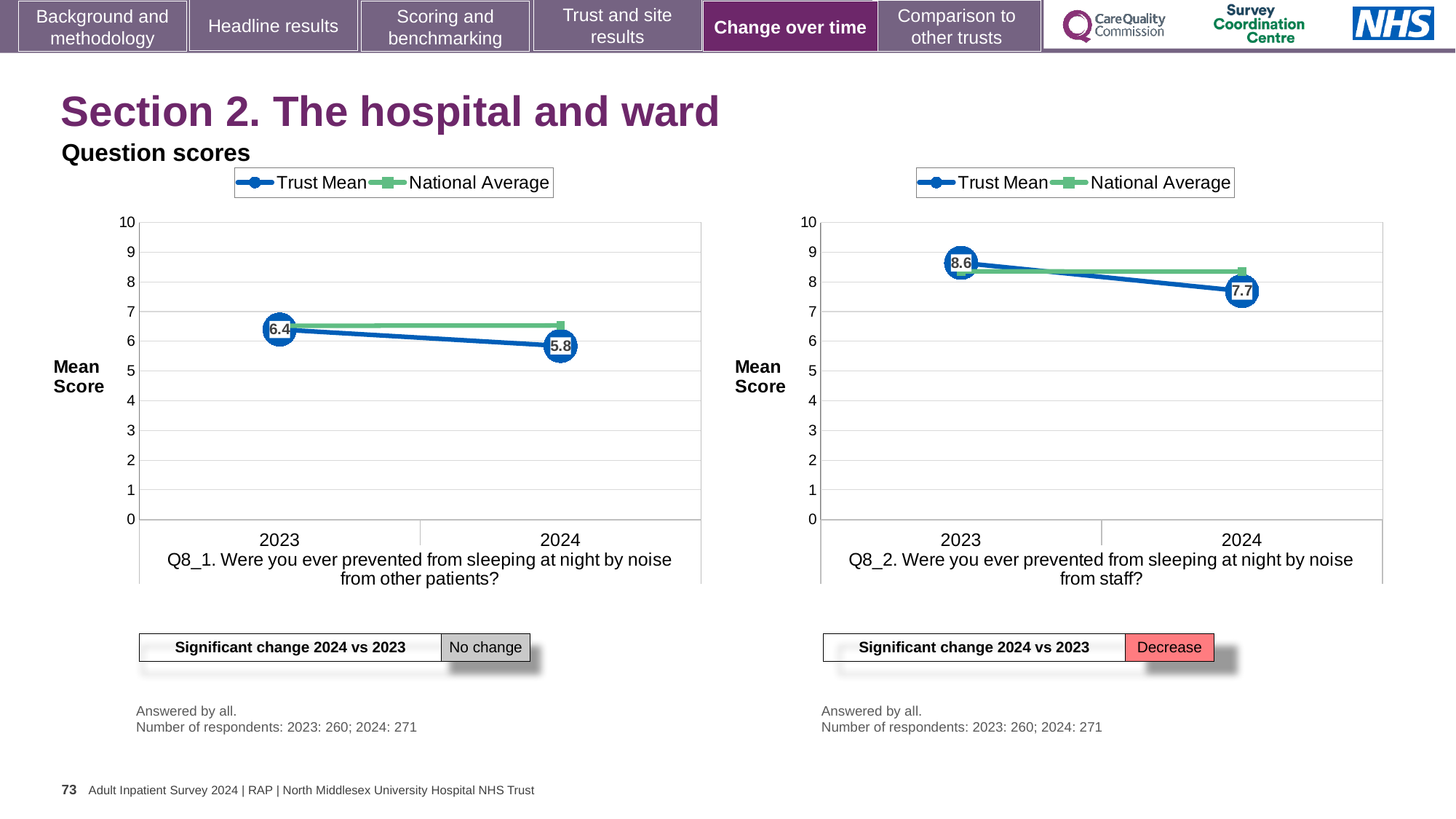
How many years are plotted on the x axis of the Q8_2 chart (right)? 2 How many series does the legend of the Q8_2 chart (right) list? 2 What kind of chart is the Q8_1 chart (left)? line chart In the Q8_2 chart (right), is the National Average value for 2024 greater or less than 8? greater In the Q8_2 chart (right), by how much did the Trust Mean fall from 2023 to 2024? 0.9 In the Q8_2 chart (right), what is the Trust Mean score for 2023? 8.6 In the Q8_1 chart (left), what is the Trust Mean score for 2024? 5.8 In the Q8_1 chart (left), does the Trust Mean rise or fall from 2023 to 2024? fall In the Q8_1 chart (left), what is the difference between the Trust Mean in 2023 and in 2024? 0.6 In the Q8_1 chart (left), which is larger in 2024: the Trust Mean or the National Average? National Average In the Q8_1 chart (left), what is the Trust Mean score for 2023? 6.4 In the Q8_2 chart (right), what is the Trust Mean score for 2024? 7.7